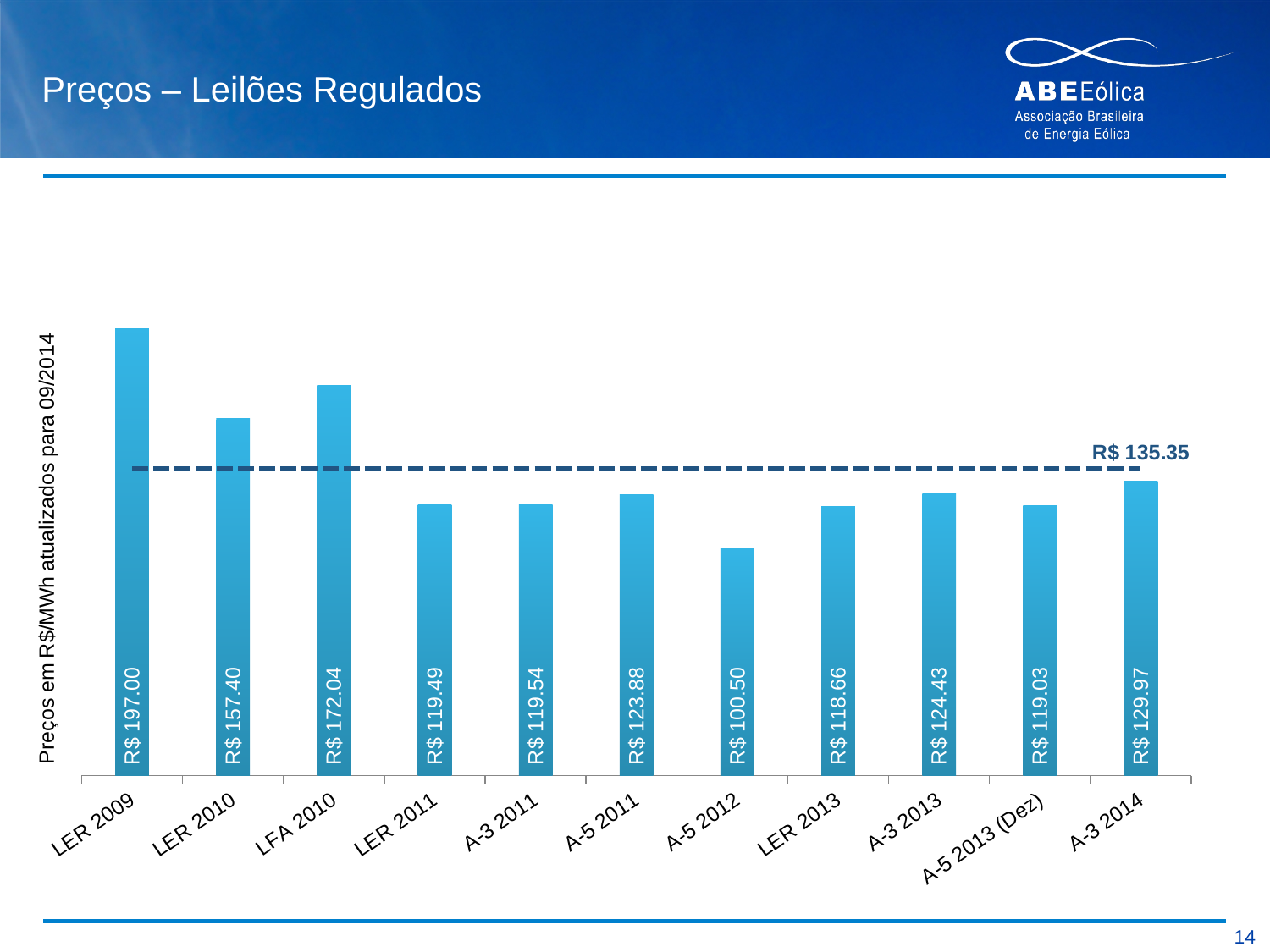
What value is labelled on the dashed horizontal line? R$ 135.35 What is the value for A-3 2014? R$ 129.97 Which auction has the highest price? LER 2009 What is the difference between the values for LER 2009 and A-5 2012? R$ 96.50 What kind of chart is shown on the slide? Bar chart What is the value for A-5 2013 (Dez)? R$ 119.03 What is the difference between the values for LFA 2010 and LER 2010? R$ 14.64 What is the value for A-5 2012? R$ 100.50 What is the value for LER 2009? R$ 197.00 Which auction has the lowest price? A-5 2012 How many auctions (bars) are shown in the chart? 11 Which is larger, the value for A-3 2013 or the value for LER 2013? A-3 2013